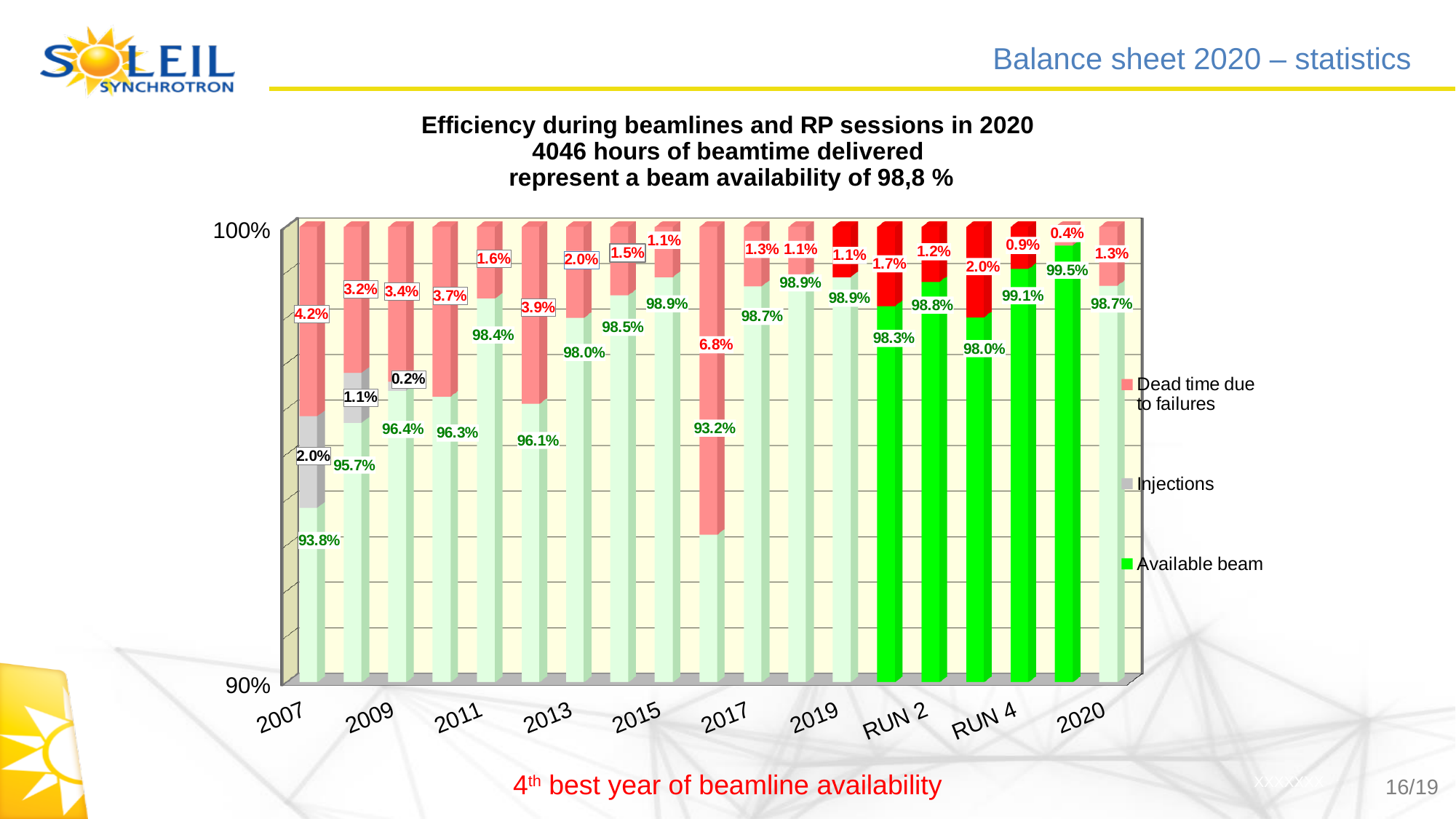
What is the Available beam value for 2020? 98.7% Which legend entry is shown in bright green? Available beam What type of chart is shown on the slide? Stacked bar chart How many series does the legend list? 3 Does the Available beam value generally rise or fall from 2007 to 2020? Rise What is the difference in Available beam between 2020 and 2007? 4.9 percentage points What is the Available beam value for RUN 2? 98.8% Which has the larger Available beam value, 2007 or 2020? 2020 What is the Dead time due to failures value for RUN 4? 0.9% What is the Available beam value for 2007? 93.8% What is the Dead time due to failures value for 2007? 4.2% What is the Injections value for 2007? 2.0%